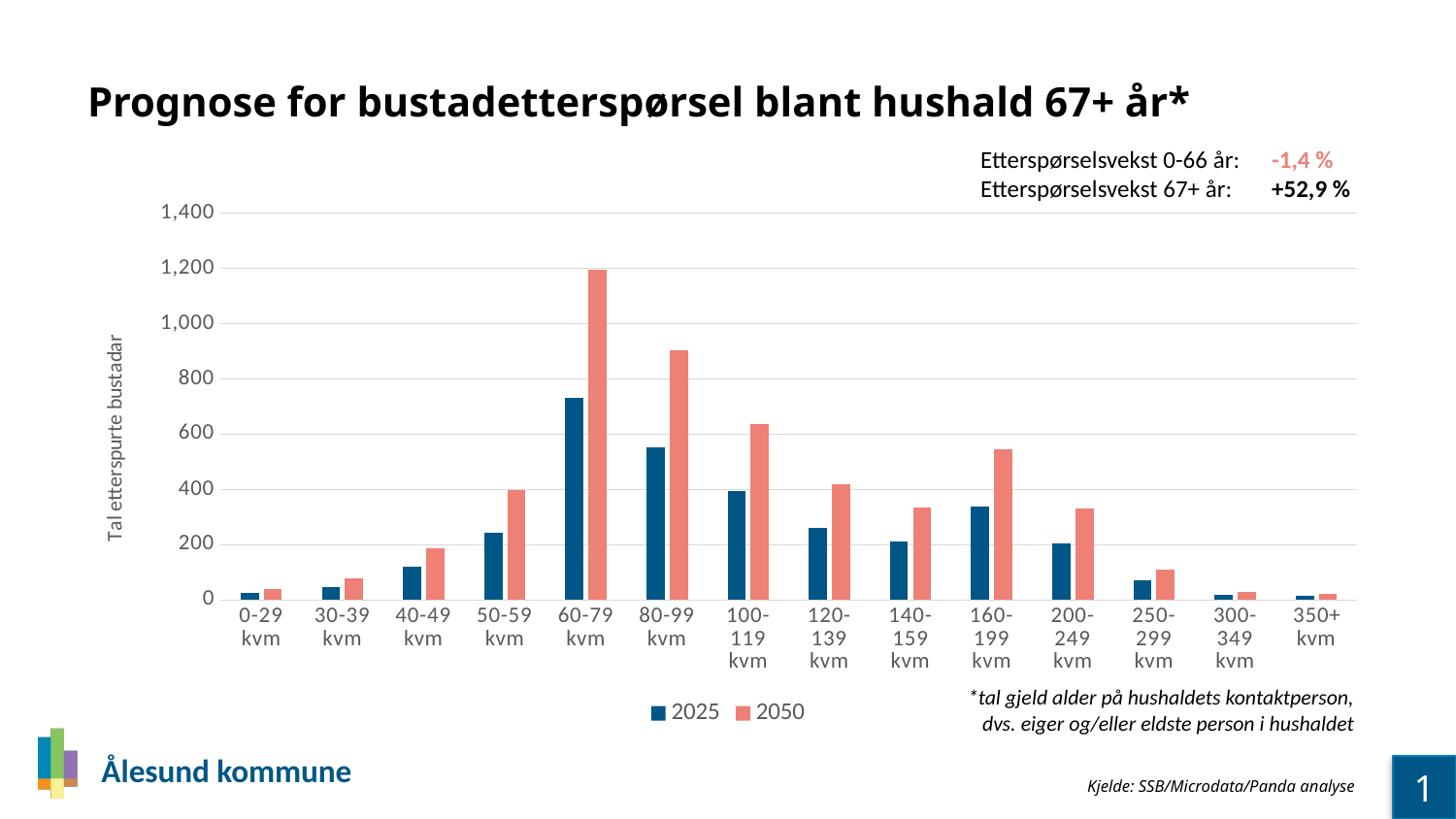
Is the 2050 value for 80-99 kvm greater or less than 800? greater Is the 2025 value for 60-79 kvm greater or less than 800? less What is the title of the chart on the slide? Prognose for bustadetterspørsel blant hushald 67+ år* For the 2050 series, which is larger: 120-139 kvm or 160-199 kvm? 160-199 kvm Which size category has the highest value for the 2050 series? 60-79 kvm For 160-199 kvm, which series has the larger value, 2025 or 2050? 2050 How many size categories (kvm groups) are shown on the x axis? 14 What kind of chart is shown on the slide? bar chart Is the 2050 value for 60-79 kvm greater or less than 1,000? greater Which size category has the highest value for the 2025 series? 60-79 kvm How many series does the legend list? 2